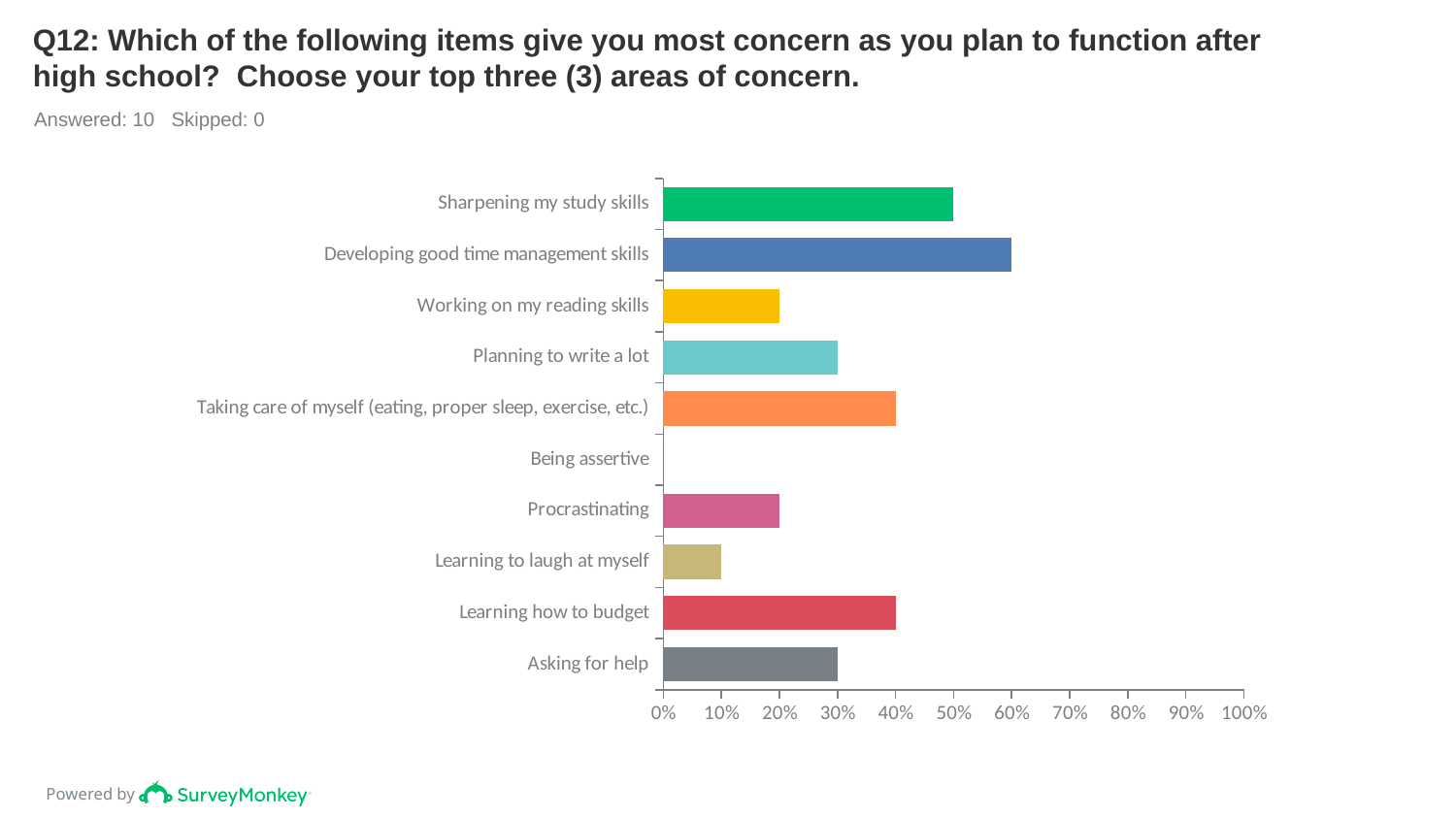
Which category has the highest value? Developing good time management skills Which category has the lowest value? Being assertive Which is larger, the value for Learning how to budget or the value for Planning to write a lot? Learning how to budget What is the value for Learning to laugh at myself? 10% What is the difference between the values for Developing good time management skills and Sharpening my study skills? 10% What kind of chart is shown on the slide? bar chart What is the value for Sharpening my study skills? 50% How many categories are plotted in the chart? 10 Is the value for Sharpening my study skills greater or less than 40%? greater What is the value for Developing good time management skills? 60% What is the value for Taking care of myself (eating, proper sleep, exercise, etc.)? 40% How many respondents answered the question according to the slide? 10